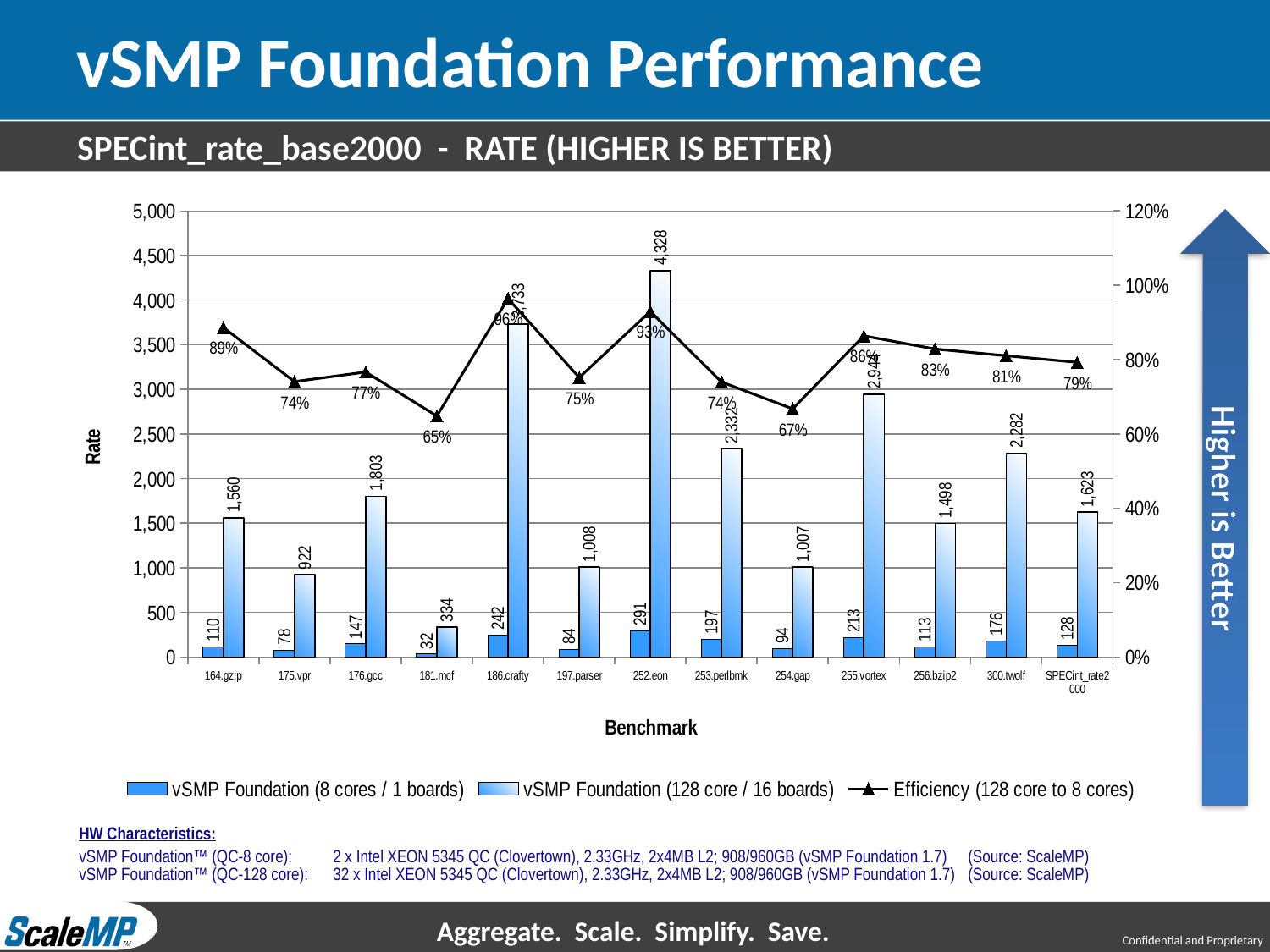
What is the difference between the 128 core / 16 boards value and the 8 cores / 1 boards value for 164.gzip? 1,450 What kind of chart is shown on the slide? bar and line chart How many series does the legend list? 3 Which benchmark has the highest vSMP Foundation (128 core / 16 boards) rate? 252.eon Is the vSMP Foundation (128 core / 16 boards) value for 255.vortex greater or less than 2,500? greater What is the Efficiency (128 core to 8 cores) value for 186.crafty? 96% What is the vSMP Foundation (128 core / 16 boards) value for the SPECint_rate2000 category? 1,623 How many benchmark categories are shown on the x axis? 13 What is the value for vSMP Foundation (8 cores / 1 boards) on the 181.mcf benchmark? 32 Which benchmark has the lowest Efficiency (128 core to 8 cores) value? 181.mcf Which is larger: the vSMP Foundation (128 core / 16 boards) value for 176.gcc or for 164.gzip? 176.gcc What is the value for vSMP Foundation (128 core / 16 boards) on the 252.eon benchmark? 4,328